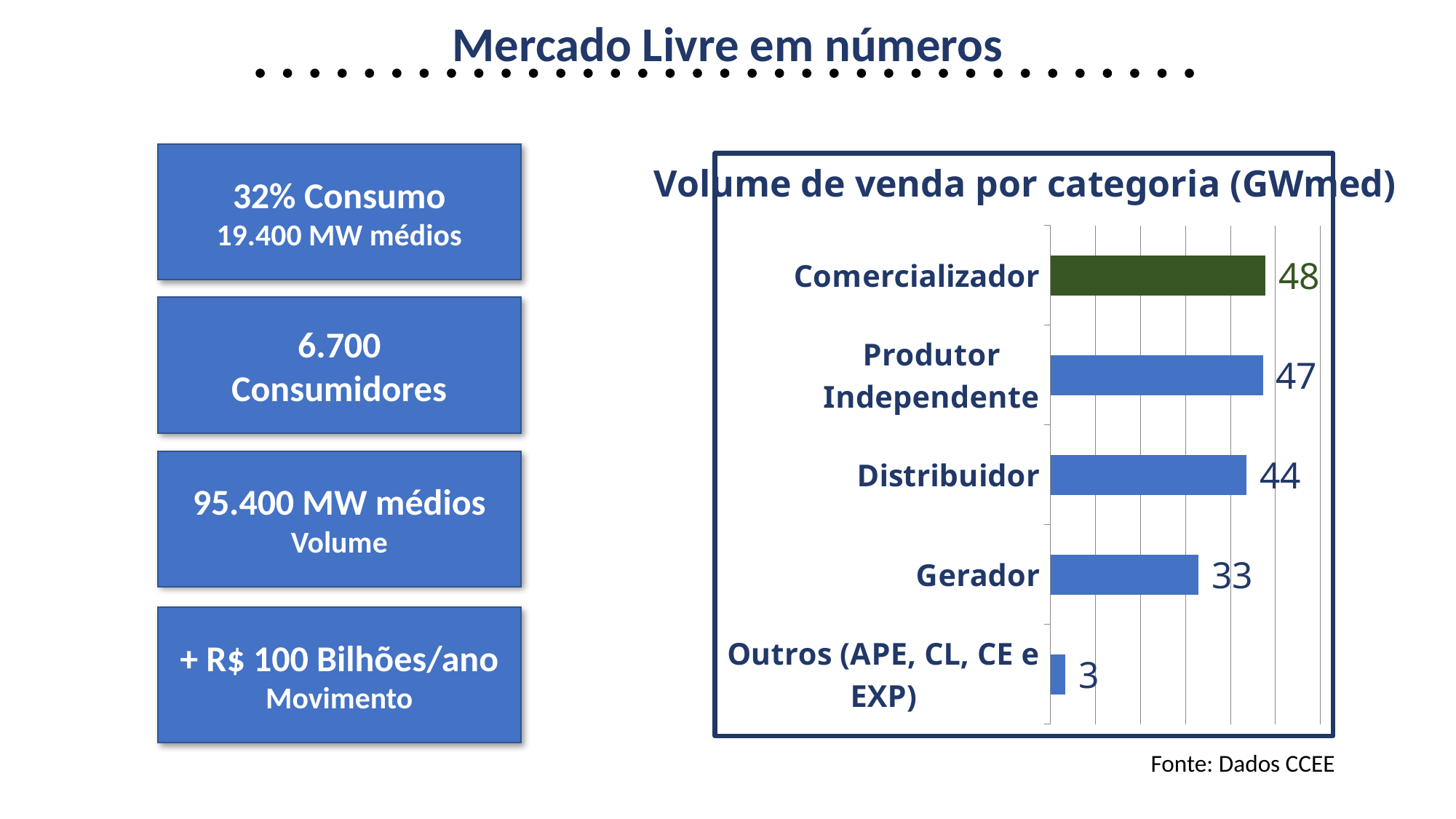
What is the value for Comercializador? 48 What is the value for Produtor Independente? 47 Which category has the highest sales volume? Comercializador What is the value for Gerador? 33 What is the title of the chart? Volume de venda por categoria (GWmed) Which category has the lowest sales volume? Outros (APE, CL, CE e EXP) What kind of chart is shown on the slide? Bar chart How many categories are shown in the chart? 5 Which is larger, the value for Gerador or the value for Distribuidor? Distribuidor What is the value for Outros (APE, CL, CE e EXP)? 3 What is the difference between the values for Distribuidor and Gerador? 11 What is the value for Distribuidor? 44